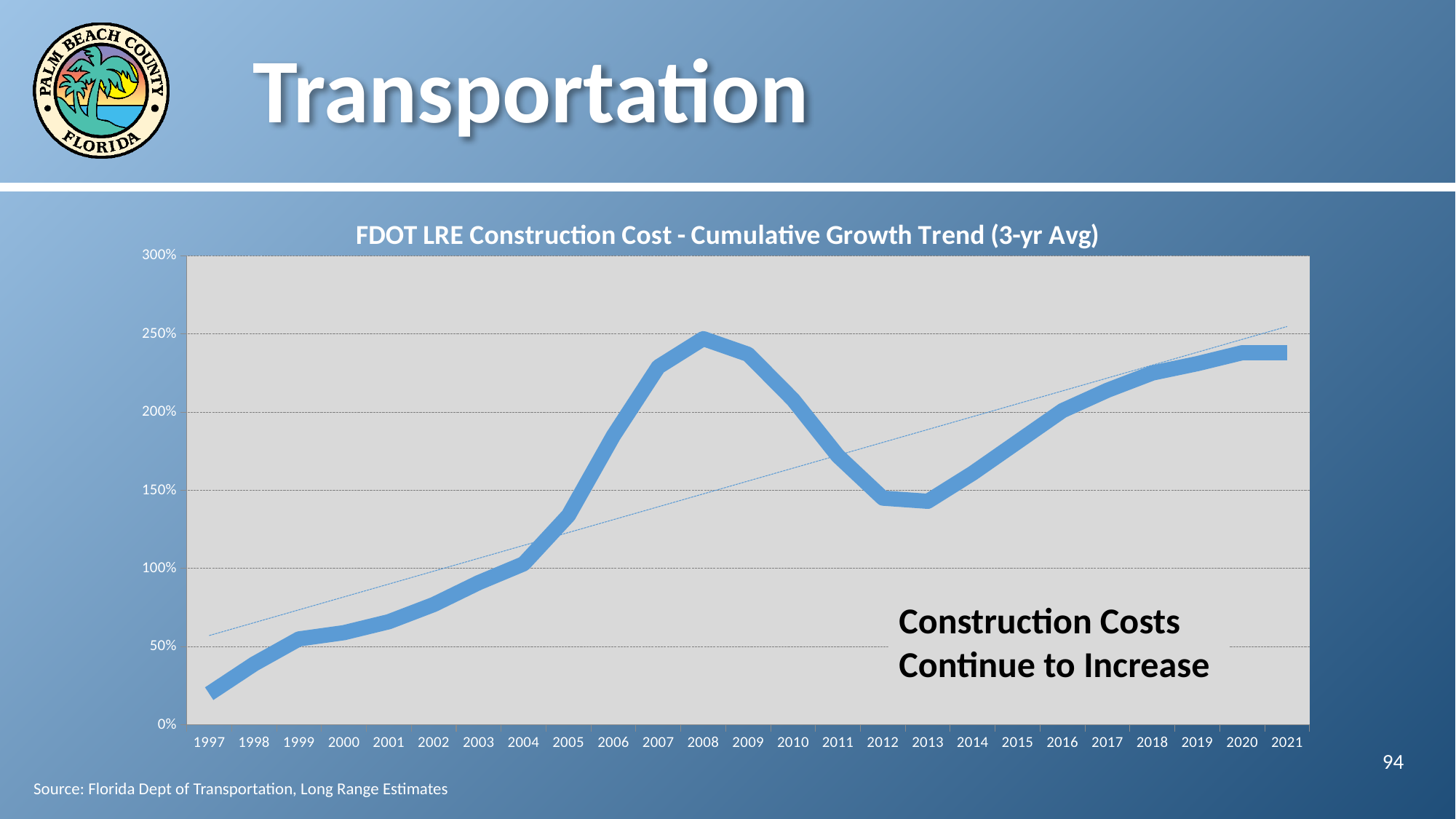
Is the value for 2001 greater or less than 100%? less What kind of chart is shown on the slide? Line chart What is the title of the chart? FDOT LRE Construction Cost - Cumulative Growth Trend (3-yr Avg) Is the value for 2021 greater or less than 200%? greater Is the value for 2008 greater or less than 200%? greater Which year has the larger value, 2005 or 2019? 2019 Overall, does the cumulative growth trend rise or fall from 1997 to 2021? Rise In which year is the cumulative growth trend at its lowest value? 1997 Which year has the larger value, 2008 or 2013? 2008 In which year does the cumulative growth trend reach its highest value? 2008 How many years are plotted along the x axis of the chart? 25